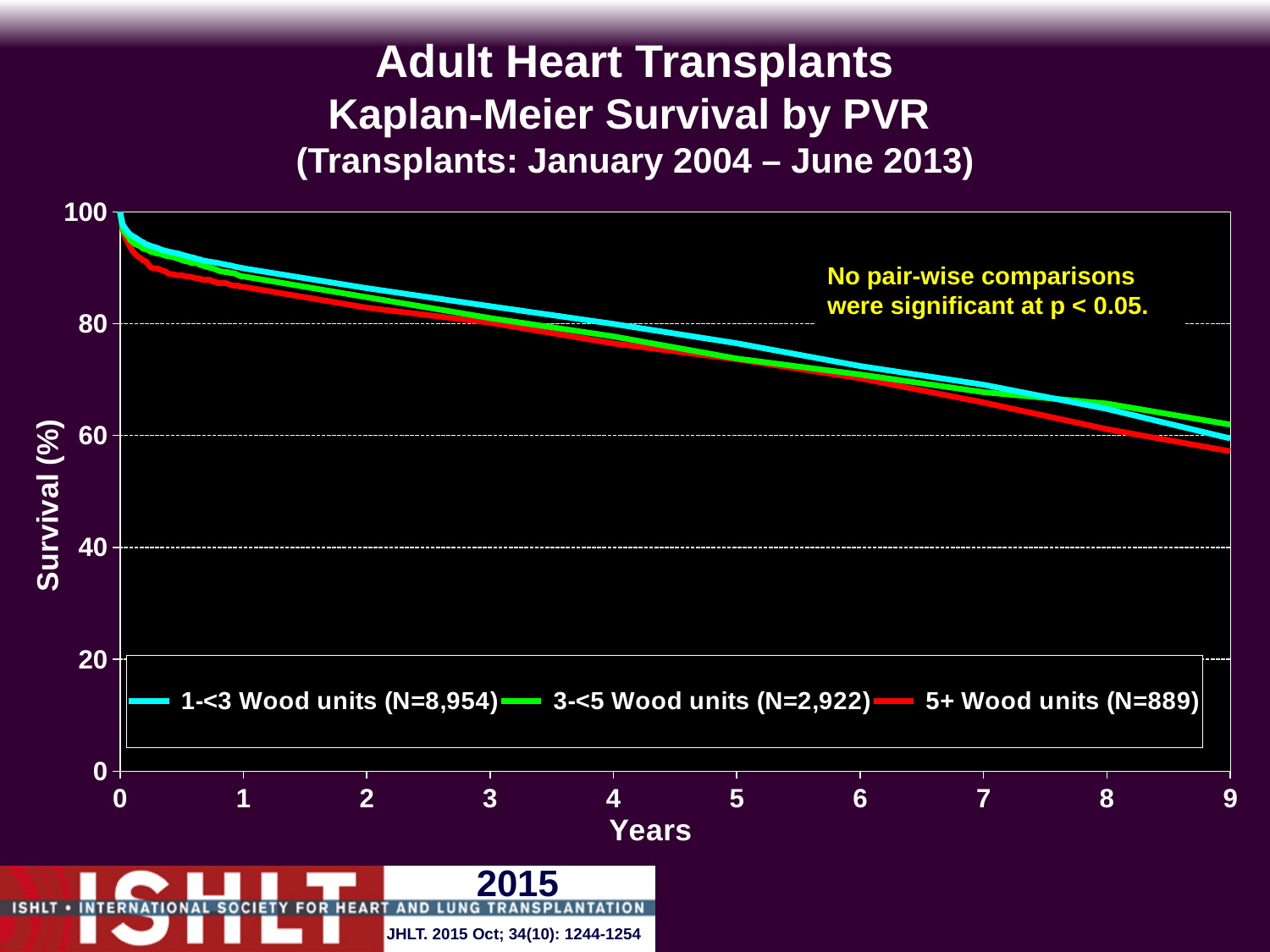
How many series does the legend list? 3 What is the label of the y axis? Survival (%) What is the highest value shown on the x axis (Years)? 9 Is the survival value for 5+ Wood units at 3 years greater or less than 60? greater Is the survival value for 1-<3 Wood units at 1 year greater or less than 80? greater At 9 years, which series has higher survival: 3-<5 Wood units or 5+ Wood units? 3-<5 Wood units Is the survival value for 5+ Wood units at 9 years greater or less than 60? less Do the survival curves rise or fall as years increase? fall What kind of chart is shown on the slide? line chart What is the number of patients (N) in the 1-<3 Wood units group according to the legend? 8,954